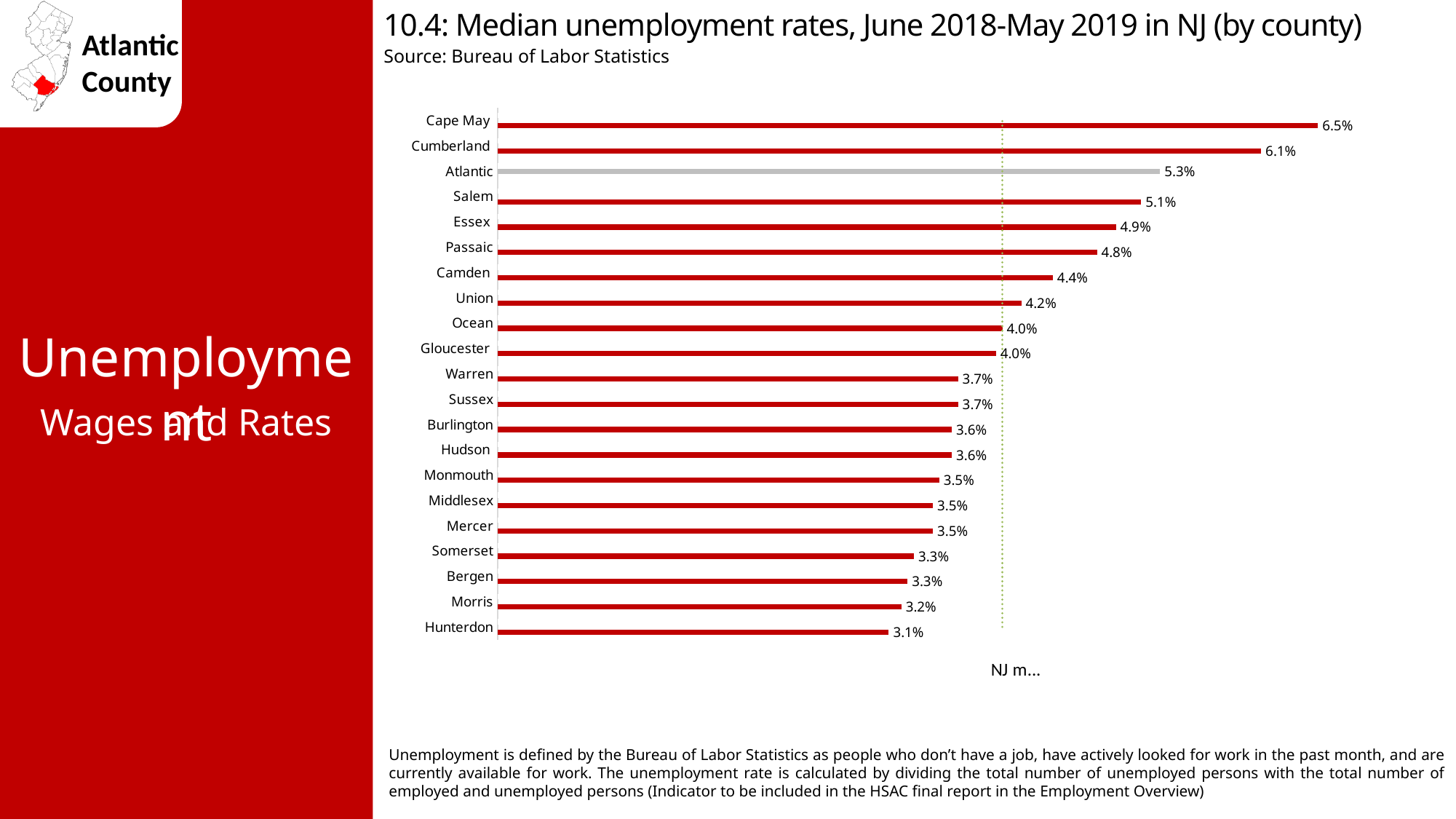
Which county has the lowest median unemployment rate? Hunterdon What is the difference between the median unemployment rates of Cape May and Cumberland? 0.4% Which county's bar is coloured grey instead of red? Atlantic Which county has the highest median unemployment rate? Cape May What is the median unemployment rate for Hunterdon? 3.1% What is the difference between the median unemployment rates of Atlantic and Hunterdon? 2.2% What kind of chart is shown on the slide? Bar chart What is the median unemployment rate for Camden? 4.4% How many counties are shown in the chart? 21 What is the source of the data in the chart? Bureau of Labor Statistics Which county has a higher median unemployment rate, Salem or Passaic? Salem What is the median unemployment rate for Atlantic County? 5.3%